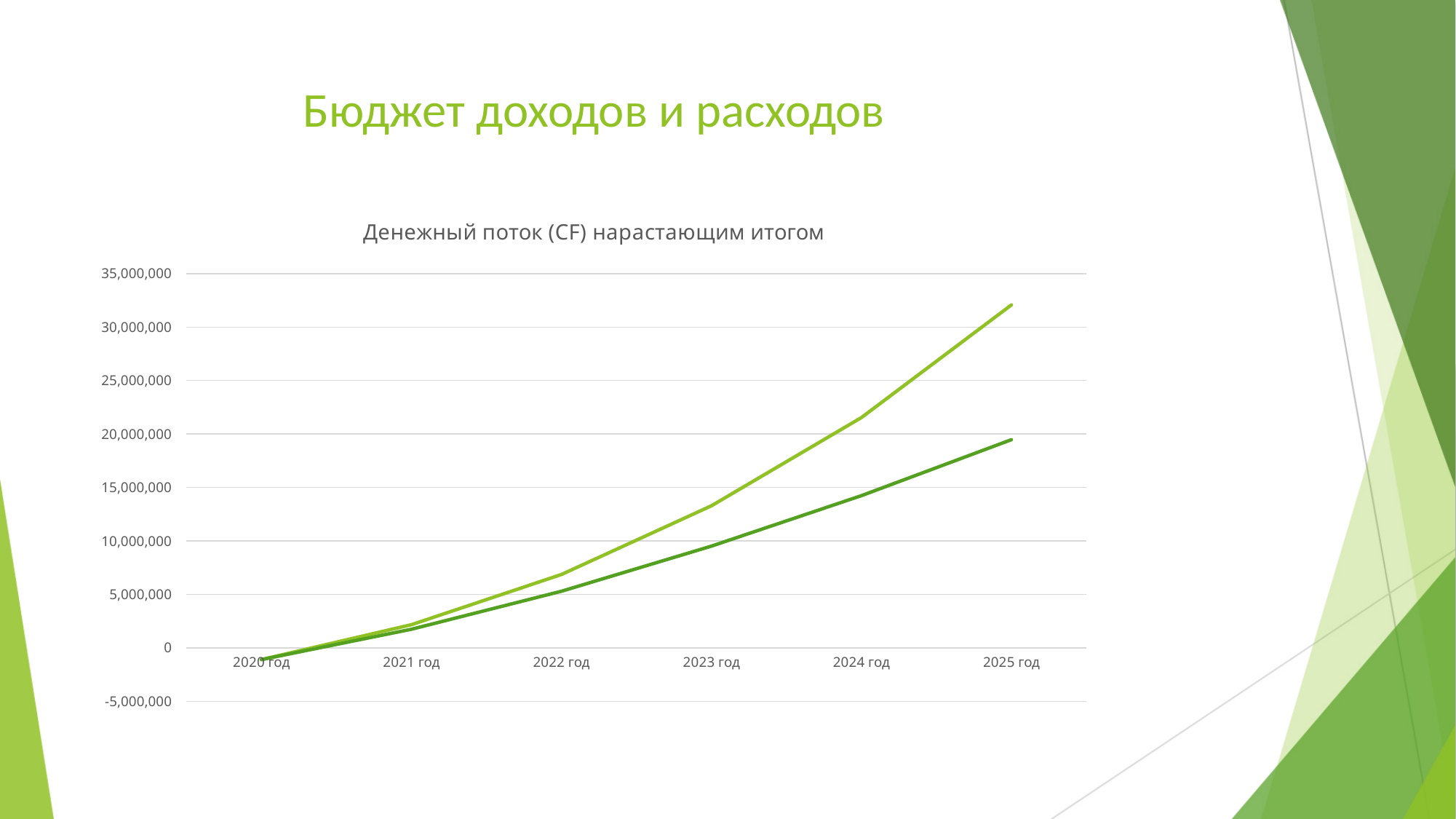
What is the title of the chart? Денежный поток (CF) нарастающим итогом Is the value of the dark green line for 2025 год greater or less than 15,000,000? greater Do the values of the lines rise or fall from 2020 год to 2025 год? rise Is the value of the light green line for 2024 год greater or less than 20,000,000? greater Is the value of the light green line for 2025 год greater or less than 30,000,000? greater In which year does the light green line reach its highest value? 2025 год What kind of chart is shown on the slide? line chart How many years are shown on the x axis of the chart? 6 How many lines are plotted on the chart? 2 At 2025 год, which line has the higher value, the light green line or the dark green line? the light green line